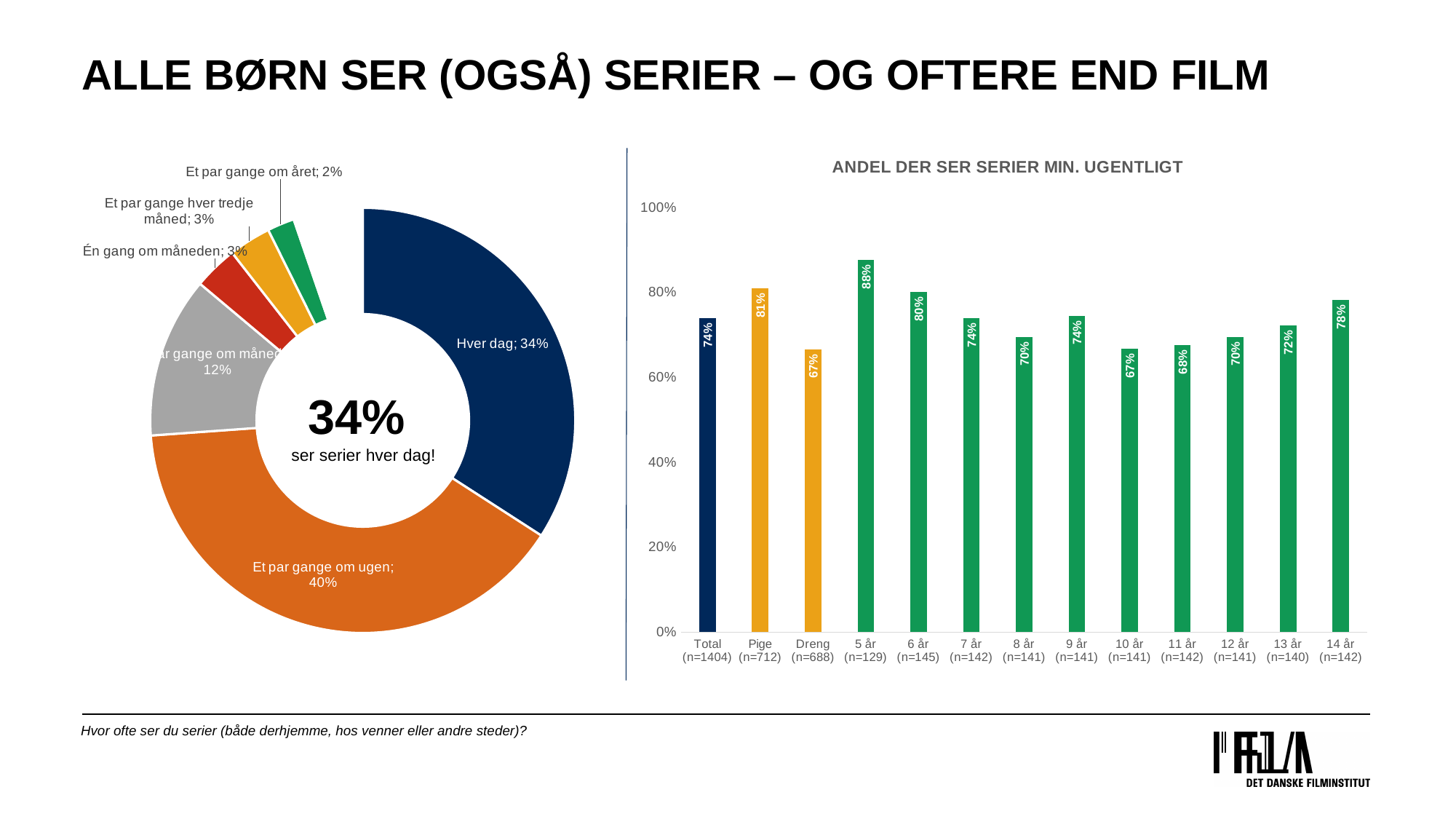
In the chart titled 'ANDEL DER SER SERIER MIN. UGENTLIGT', which is larger, the value for 6 år or the value for 14 år? 6 år What text is shown in the centre of the doughnut chart on the left? 34% ser serier hver dag! What kind of chart is the chart titled 'ANDEL DER SER SERIER MIN. UGENTLIGT'? bar chart In the chart titled 'ANDEL DER SER SERIER MIN. UGENTLIGT', what is the difference between the values for Pige and Dreng? 14% In the chart titled 'ANDEL DER SER SERIER MIN. UGENTLIGT', which category has the highest value? 5 år (n=129) In the doughnut chart on the left, which is larger, the slice for 'Hver dag' or the slice for 'Et par gange om ugen'? Et par gange om ugen In the chart titled 'ANDEL DER SER SERIER MIN. UGENTLIGT', is the value for 10 år greater or less than 80%? less In the chart titled 'ANDEL DER SER SERIER MIN. UGENTLIGT', what is the value for Pige (n=712)? 81% In the doughnut chart on the left, what share is labelled 'Hver dag'? 34% In the chart titled 'ANDEL DER SER SERIER MIN. UGENTLIGT', what is the value for Total (n=1404)? 74% In the chart titled 'ANDEL DER SER SERIER MIN. UGENTLIGT', how many categories are shown on the x axis? 13 In the doughnut chart on the left, what share is labelled 'Et par gange om ugen'? 40%